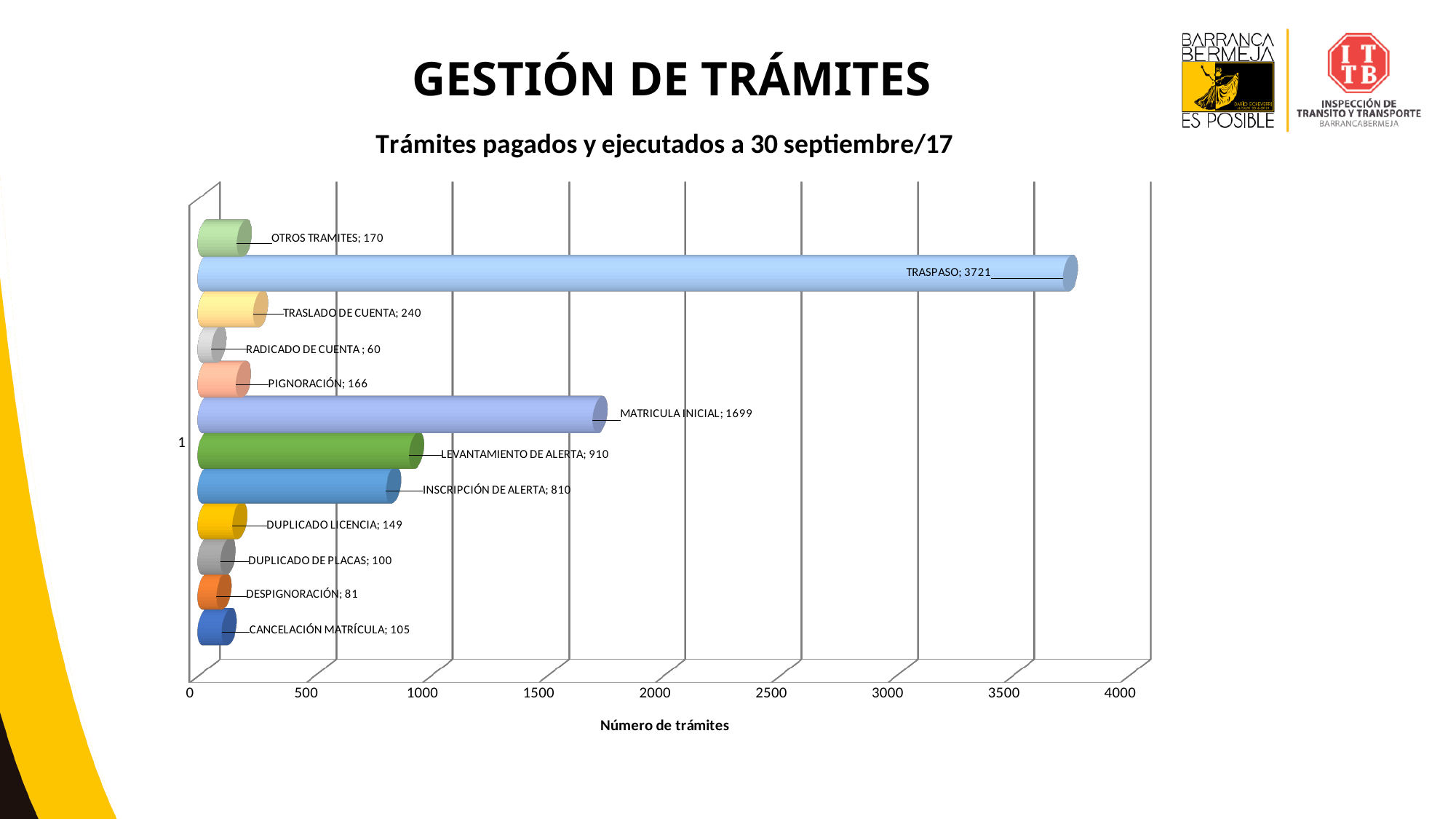
Is the value for MATRICULA INICIAL greater or less than 1500? greater What is the value for MATRICULA INICIAL? 1699 What is the value for TRASPASO? 3721 Which category has the lowest number of trámites? RADICADO DE CUENTA What is the difference between LEVANTAMIENTO DE ALERTA and INSCRIPCIÓN DE ALERTA? 100 Which is larger, TRASLADO DE CUENTA or OTROS TRAMITES? TRASLADO DE CUENTA How many categories are plotted in the chart? 12 What kind of chart is shown on the slide? bar chart What is the title of the chart? Trámites pagados y ejecutados a 30 septiembre/17 Which category has the highest number of trámites? TRASPASO What is the value for RADICADO DE CUENTA? 60 What is the label of the horizontal axis? Número de trámites